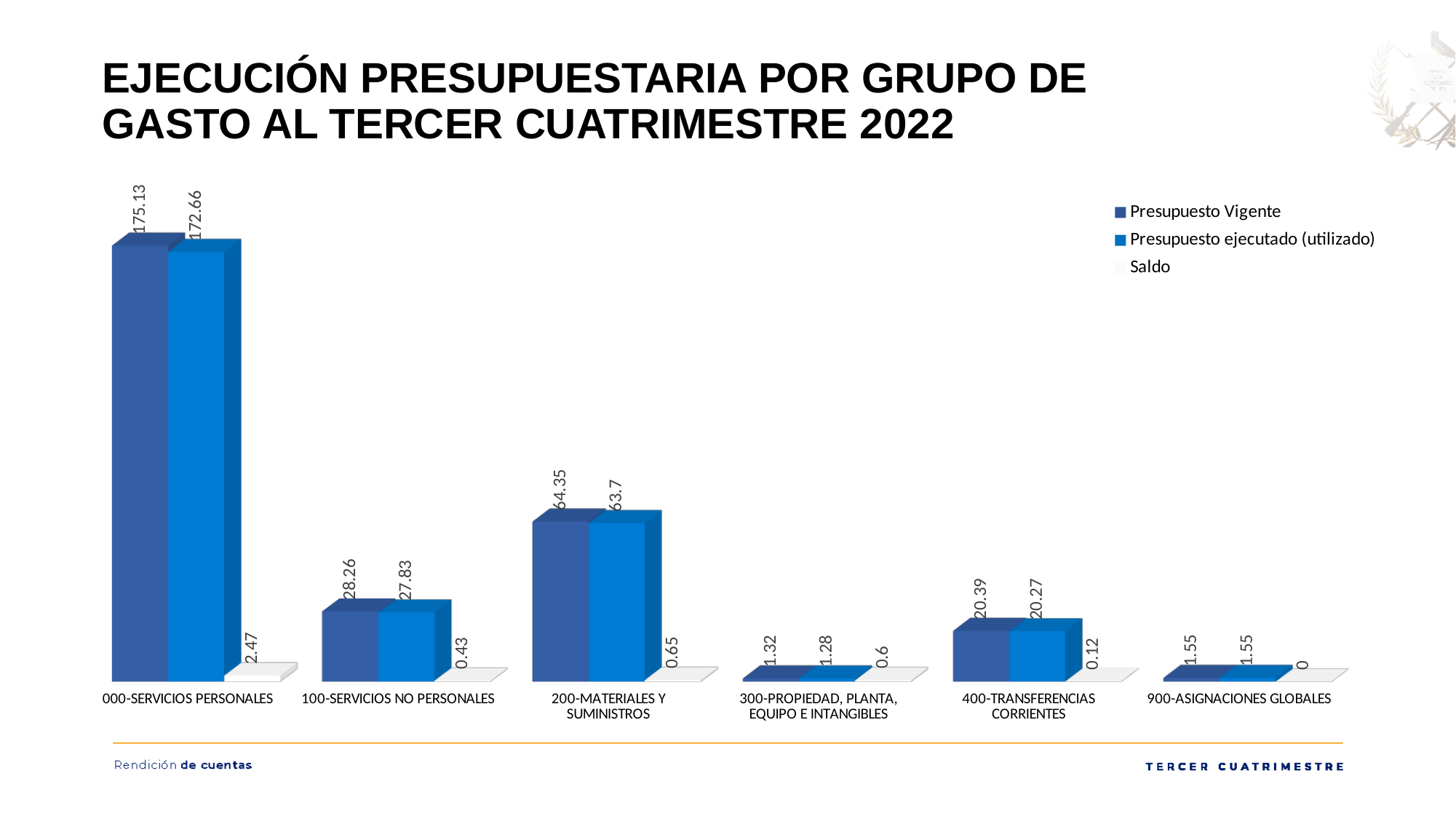
How many categories are shown on the x axis? 6 What is the Presupuesto ejecutado (utilizado) value for 200-MATERIALES Y SUMINISTROS? 63.7 What is the Presupuesto Vigente value for 400-TRANSFERENCIAS CORRIENTES? 20.39 What kind of chart is shown on the slide? Bar chart Which category has the highest Presupuesto Vigente value? 000-SERVICIOS PERSONALES What is the Presupuesto Vigente value for 000-SERVICIOS PERSONALES? 175.13 Which is larger: the Presupuesto Vigente for 100-SERVICIOS NO PERSONALES or for 200-MATERIALES Y SUMINISTROS? 200-MATERIALES Y SUMINISTROS Which category has the lowest Presupuesto ejecutado (utilizado) value? 300-PROPIEDAD, PLANTA, EQUIPO E INTANGIBLES What is the Saldo value for 900-ASIGNACIONES GLOBALES? 0 What is the Saldo value for 100-SERVICIOS NO PERSONALES? 0.43 How many series does the legend list? 3 What is the difference between Presupuesto Vigente and Presupuesto ejecutado (utilizado) for 000-SERVICIOS PERSONALES? 2.47